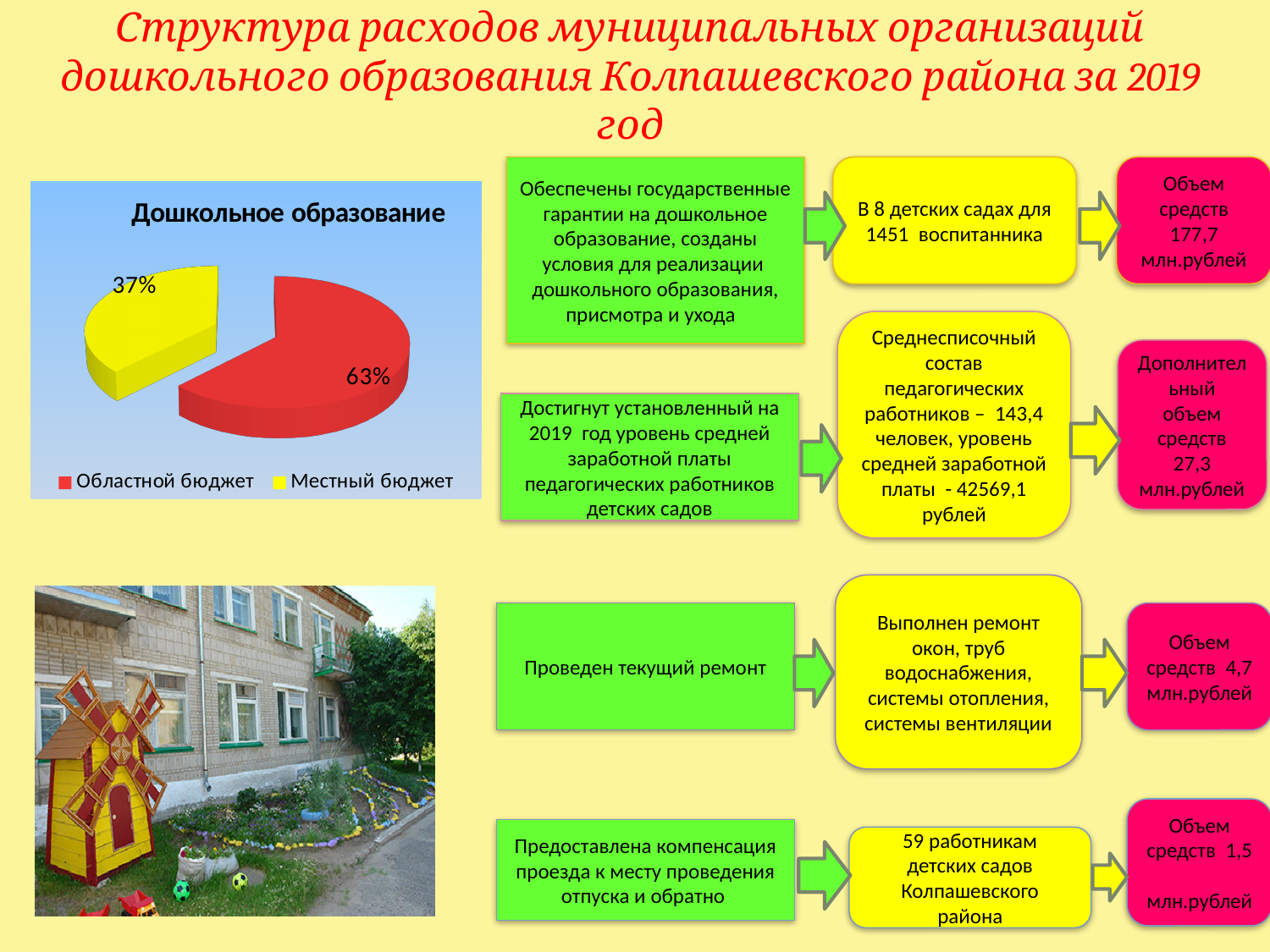
Which category has the smallest slice of the pie? Местный бюджет Which is larger, the share for Областной бюджет or the share for Местный бюджет? Областной бюджет What is the title of the chart? Дошкольное образование Which category has the largest slice of the pie? Областной бюджет What share of the pie does Областной бюджет have? 63% What is the difference in percentage points between Областной бюджет and Местный бюджет? 26 How many entries does the legend list? 2 What colour is the slice for Местный бюджет? yellow How many slices does the pie chart have? 2 What share of the pie does Местный бюджет have? 37% What type of chart is shown on the slide? pie chart